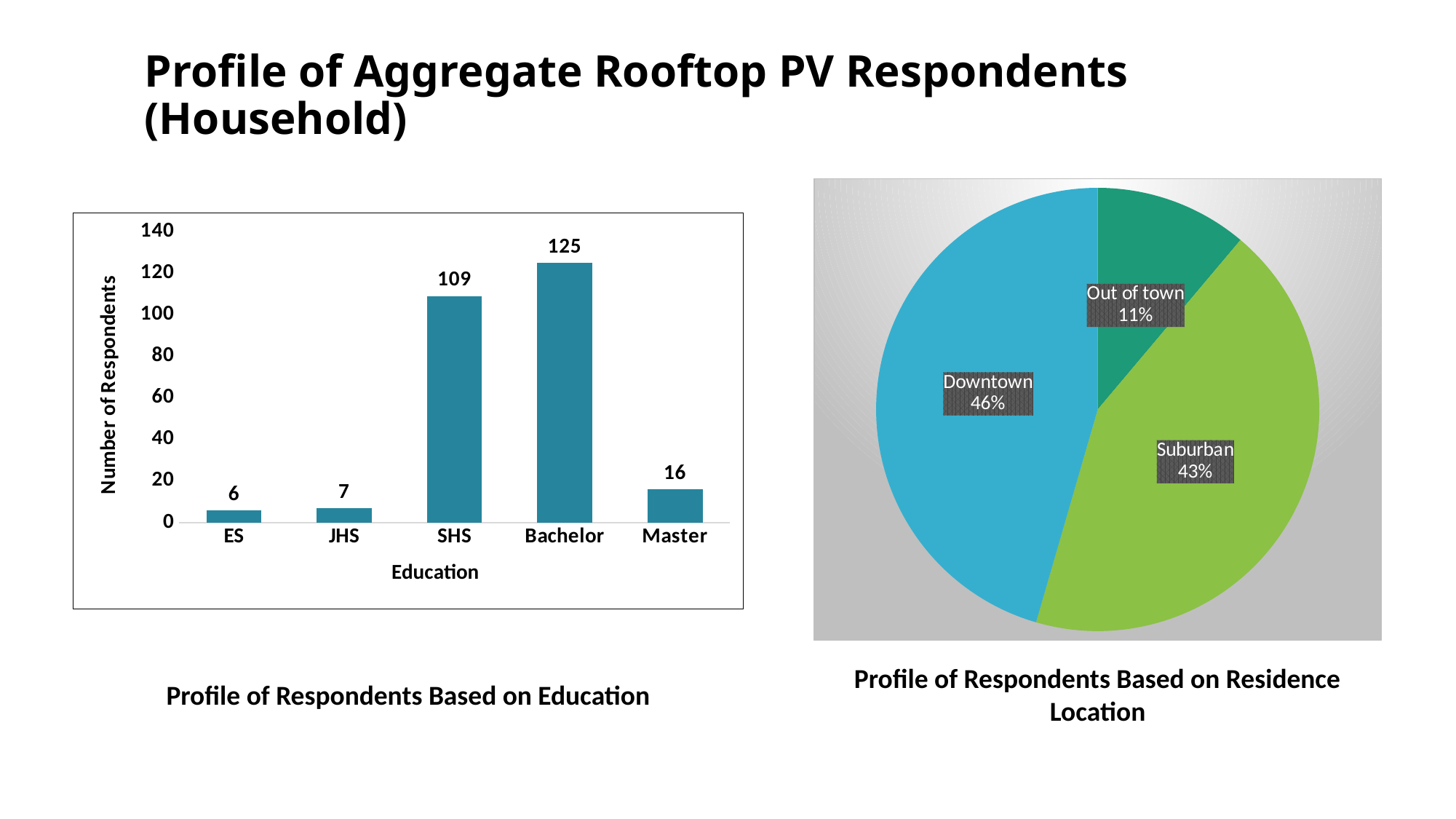
In the 'Profile of Respondents Based on Education' chart, what is the number of respondents for SHS? 109 In the 'Profile of Respondents Based on Education' chart, which has more respondents, Master or JHS? Master In the 'Profile of Respondents Based on Education' chart, which education category has the highest number of respondents? Bachelor In the 'Profile of Respondents Based on Education' chart, which education category has the lowest number of respondents? ES In the 'Profile of Respondents Based on Education' chart, how many education categories are shown? 5 In the 'Profile of Respondents Based on Residence Location' chart, which residence location has the smallest share? Out of town In the 'Profile of Respondents Based on Residence Location' chart, what share of respondents live Downtown? 46% What type of chart is the 'Profile of Respondents Based on Education' chart? Bar chart In the 'Profile of Respondents Based on Education' chart, how many respondents have a Bachelor education? 125 In the 'Profile of Respondents Based on Residence Location' chart, how many slices does the pie have? 3 What is the y-axis label of the 'Profile of Respondents Based on Education' chart? Number of Respondents In the 'Profile of Respondents Based on Education' chart, what is the difference between the number of Bachelor and SHS respondents? 16